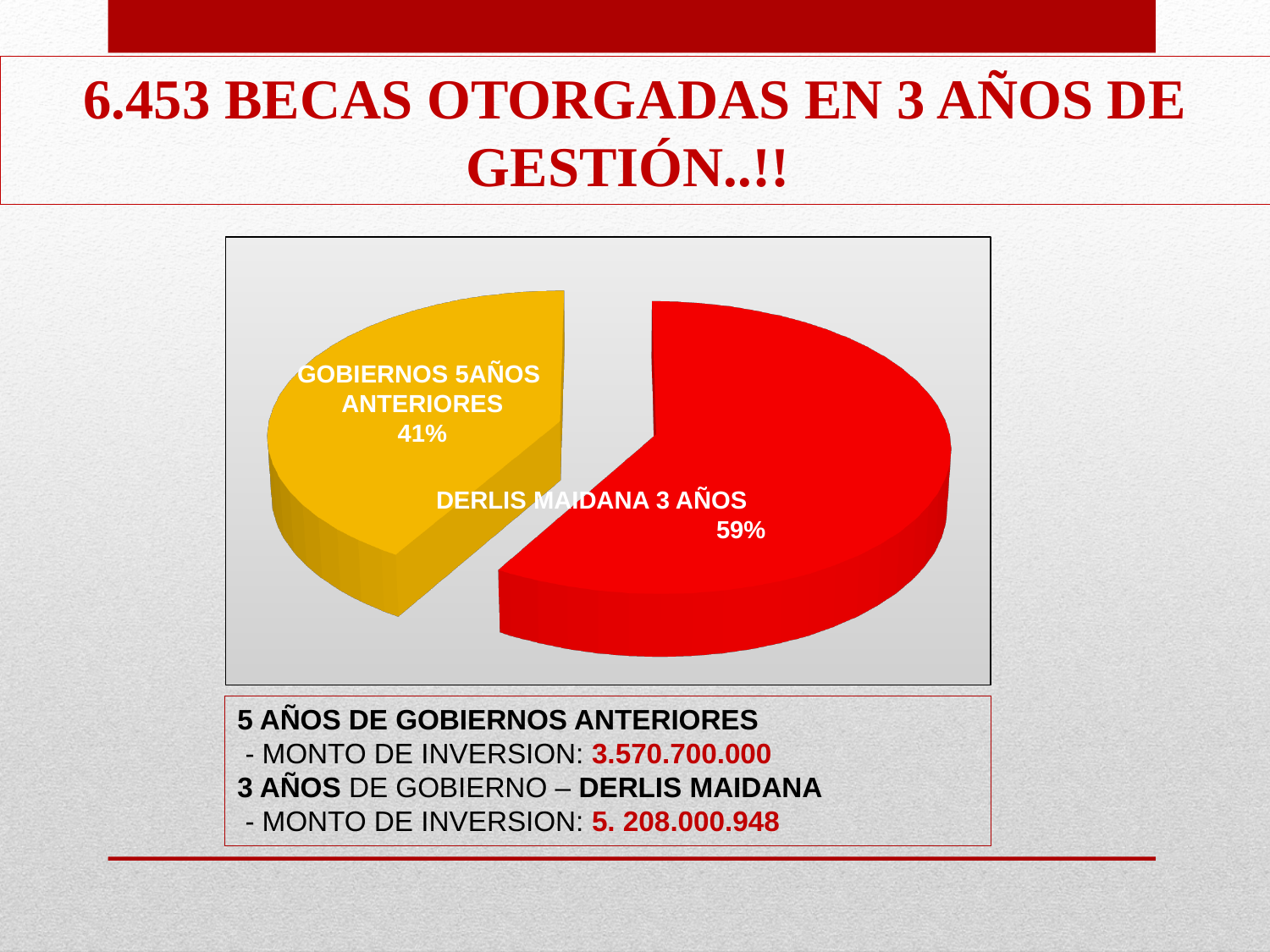
Which slice of the pie is the smallest? GOBIERNOS 5AÑOS ANTERIORES Which is larger, the share for DERLIS MAIDANA 3 AÑOS or the share for GOBIERNOS 5AÑOS ANTERIORES? DERLIS MAIDANA 3 AÑOS What kind of chart is shown on the slide? Pie chart How many slices does the pie chart have? 2 Which slice of the pie is the largest? DERLIS MAIDANA 3 AÑOS What share of the pie does the DERLIS MAIDANA 3 AÑOS slice represent? 59% What is the difference in percentage points between the DERLIS MAIDANA 3 AÑOS slice and the GOBIERNOS 5AÑOS ANTERIORES slice? 18 percentage points Is the share for GOBIERNOS 5AÑOS ANTERIORES greater or less than 50%? less What colour is the GOBIERNOS 5AÑOS ANTERIORES slice? Yellow What share of the pie does the GOBIERNOS 5AÑOS ANTERIORES slice represent? 41% What colour is the DERLIS MAIDANA 3 AÑOS slice? Red